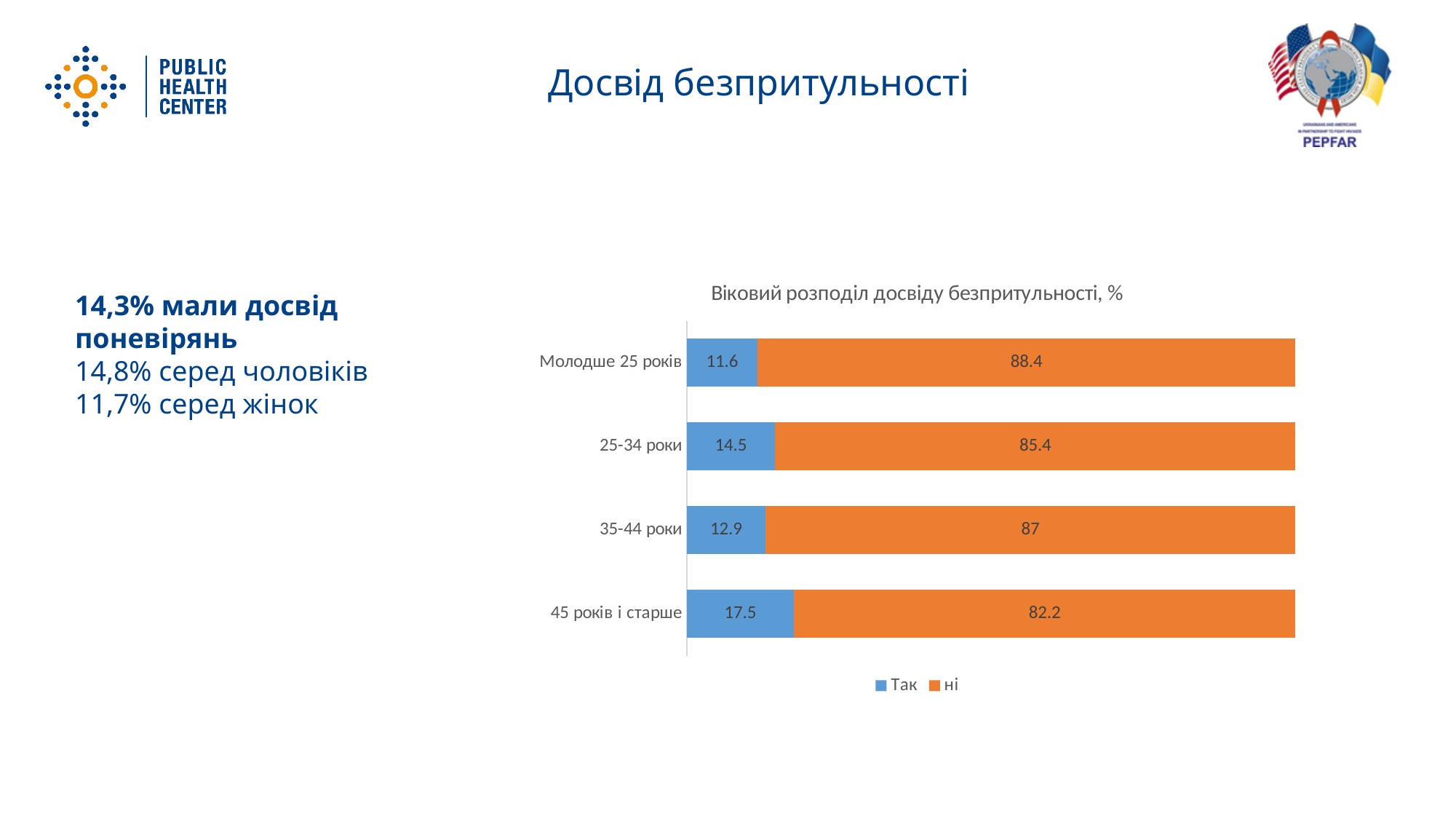
What kind of chart is shown on the slide? Stacked bar chart What is the difference between the "Так" values for "45 років і старше" and "Молодше 25 років"? 5.9 How many series does the legend list? 2 What is the value for "ні" in the "35-44 роки" category? 87 What is the value for "Так" in the "45 років і старше" category? 17.5 What is the title of the chart? Віковий розподіл досвіду безпритульності, % How many age categories are shown in the chart? 4 What is the value for "Так" in the "25-34 роки" category? 14.5 Which age category has the highest value for "Так"? 45 років і старше Which age category has the lowest value for "Так"? Молодше 25 років Which is larger: the "Так" value for "25-34 роки" or for "35-44 роки"? 25-34 роки What is the value for "ні" in the "Молодше 25 років" category? 88.4